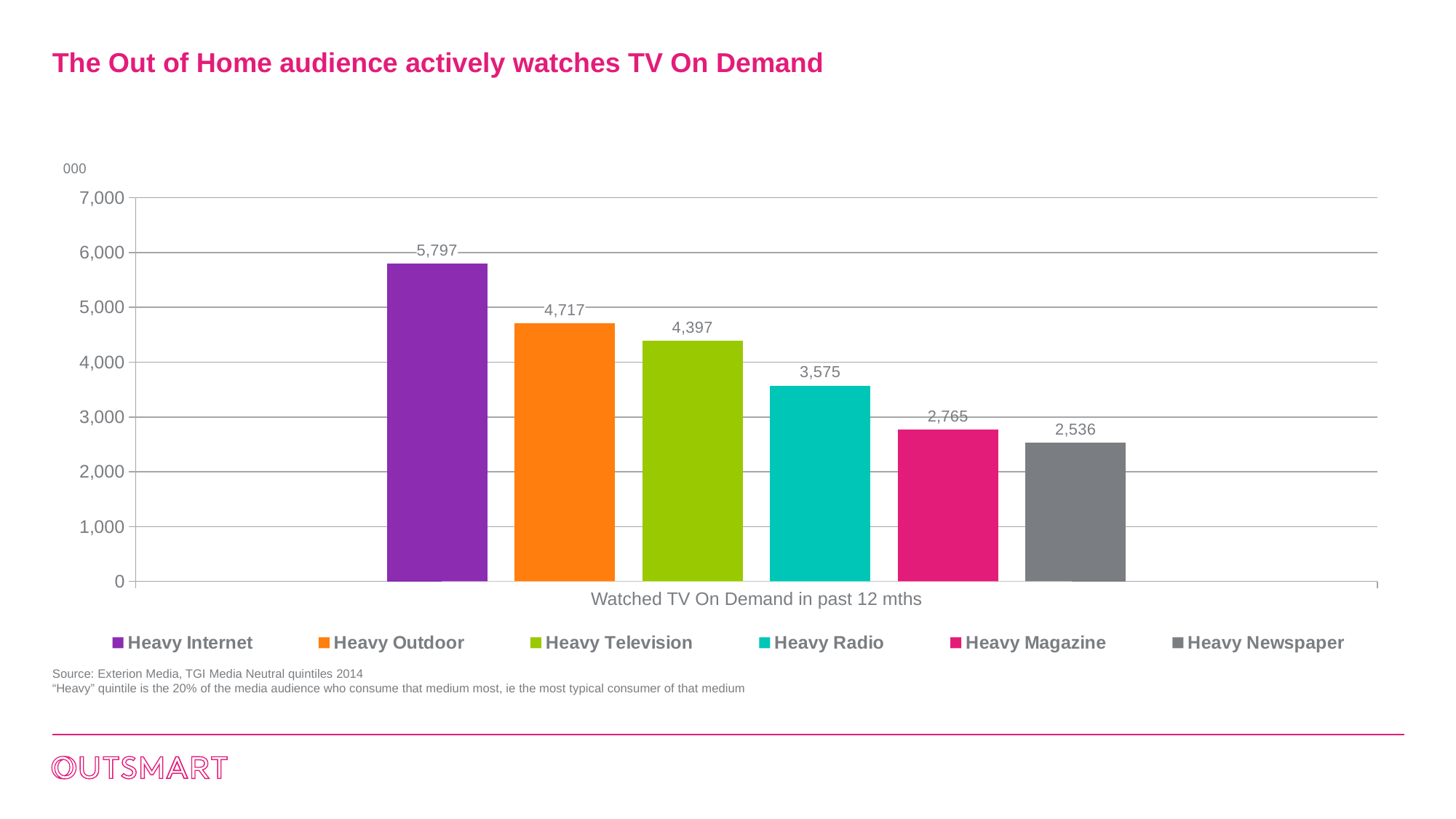
What is the value for Heavy Newspaper? 2,536 What is the value for Heavy Radio? 3,575 Which series has the lowest value? Heavy Newspaper What is the difference between the values for Heavy Internet and Heavy Newspaper? 3,261 Is the value for Heavy Outdoor greater or less than 4,000? greater What is the x-axis category label under the bars? Watched TV On Demand in past 12 mths What is the value for Heavy Internet? 5,797 How many series does the legend list? 6 Which is larger, the value for Heavy Magazine or the value for Heavy Radio? Heavy Radio What is the difference between the values for Heavy Outdoor and Heavy Television? 320 What kind of chart is shown on the slide? bar chart Which series has the highest value? Heavy Internet